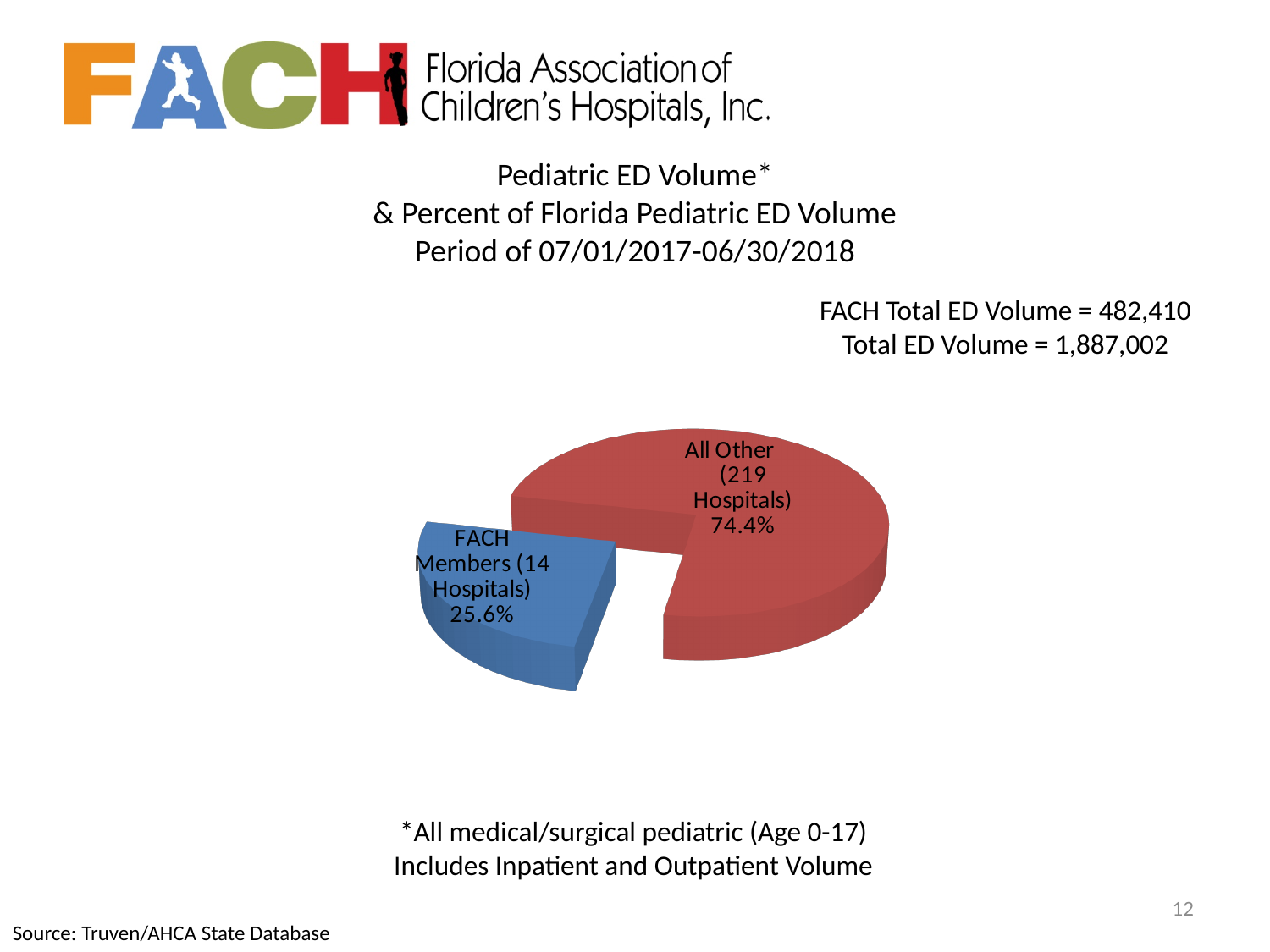
What colour is the FACH Members slice of the pie chart? Blue What kind of chart is shown on the slide? Pie chart Which is larger: the share for FACH Members or the share for All Other? All Other What is the FACH Total ED Volume stated on the slide? 482,410 What percentage of Florida pediatric ED volume is attributed to FACH Members (14 Hospitals)? 25.6% How many slices does the pie chart have? 2 Which slice of the pie chart is the smallest? FACH Members (14 Hospitals) What is the Total ED Volume stated on the slide? 1,887,002 Which slice of the pie chart is the largest? All Other (219 Hospitals) What period does the chart cover? 07/01/2017-06/30/2018 What percentage of Florida pediatric ED volume is attributed to All Other (219 Hospitals)? 74.4% What is the difference in percentage points between the All Other slice and the FACH Members slice? 48.8